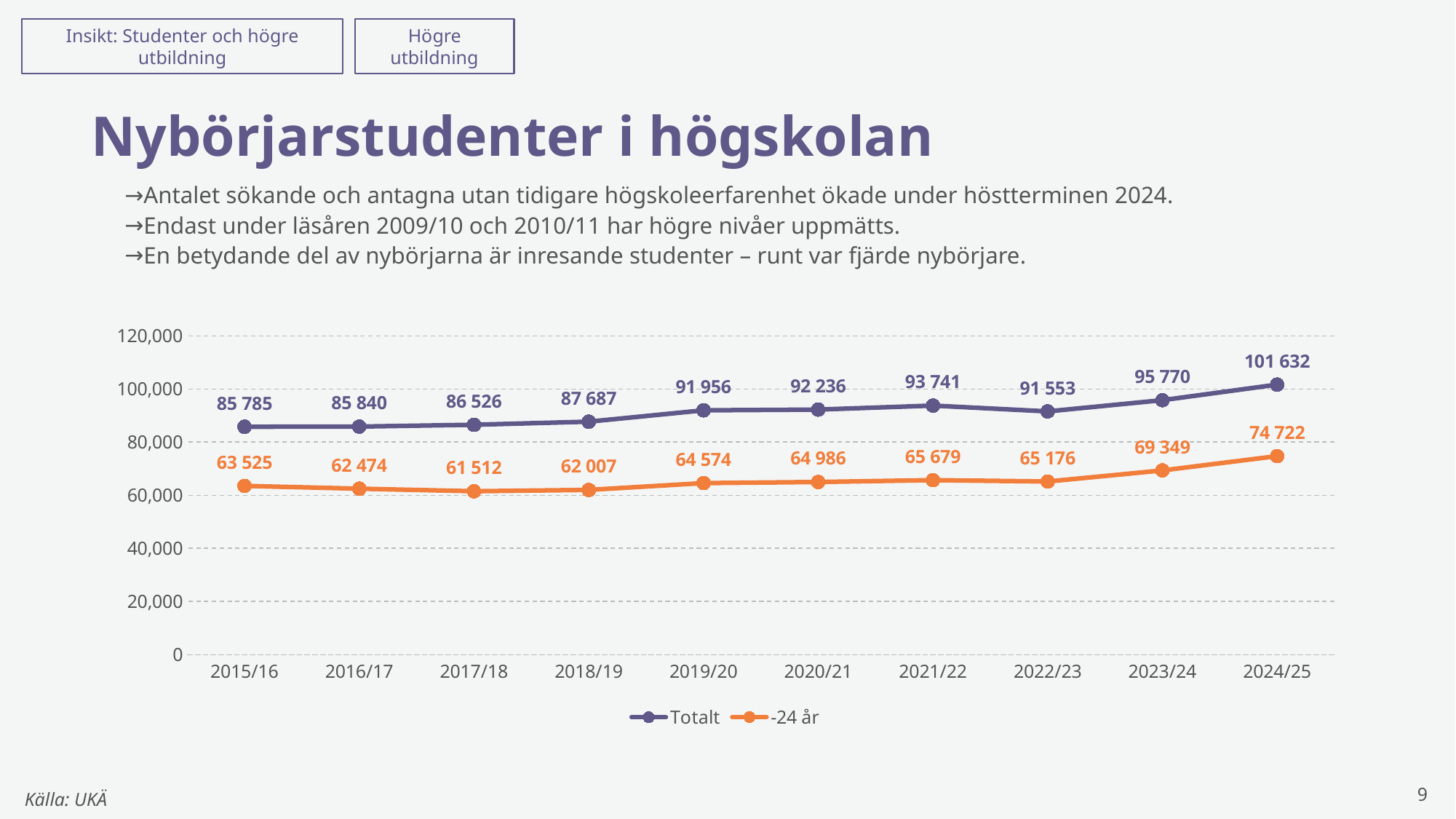
By how much did the Totalt value increase from 2023/24 to 2024/25? 5 862 How many academic years are shown on the x axis? 10 What is the difference between the Totalt value and the -24 år value for 2024/25? 26 910 In which academic year is the -24 år series at its lowest? 2017/18 Is the Totalt value for 2024/25 greater or less than 100,000? greater What is the value of the Totalt series for 2019/20? 91 956 How many series does the legend list? 2 What kind of chart is shown on the slide? line chart In which academic year is the Totalt series at its highest? 2024/25 Which is larger, the Totalt value for 2021/22 or the Totalt value for 2022/23? 2021/22 What is the value of the -24 år series for 2017/18? 61 512 What is the value of the Totalt series for 2024/25? 101 632